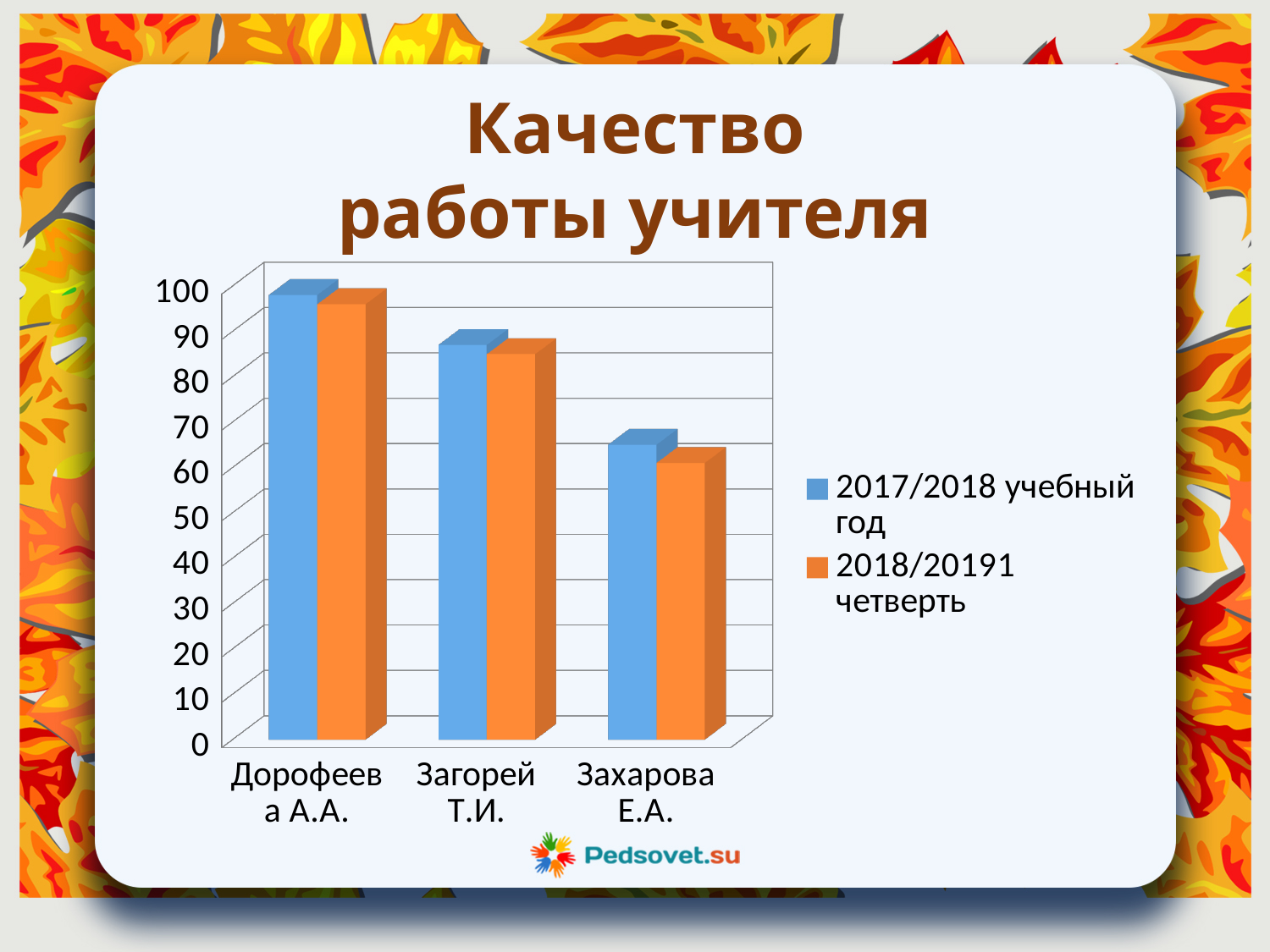
Is the 2018/2019 1 четверть value for Захарова Е.А. greater or less than 70? less What is the title of the chart on the slide? Качество работы учителя What kind of chart is shown on the slide? bar chart For Захарова Е.А., which series has the larger value: 2017/2018 учебный год or 2018/2019 1 четверть? 2017/2018 учебный год How many teachers (categories) are shown on the x axis of the chart? 3 Which teacher has the highest value for the 2017/2018 учебный год series? Дорофеева А.А. Is the 2017/2018 учебный год value for Загорей Т.И. greater or less than 80? greater Do the values for the 2017/2018 учебный год series rise or fall from left to right across the teachers? fall Is the 2017/2018 учебный год value for Захарова Е.А. greater or less than 50? greater Which teacher has the lowest value for the 2018/2019 1 четверть series? Захарова Е.А. How many series does the chart's legend list? 2